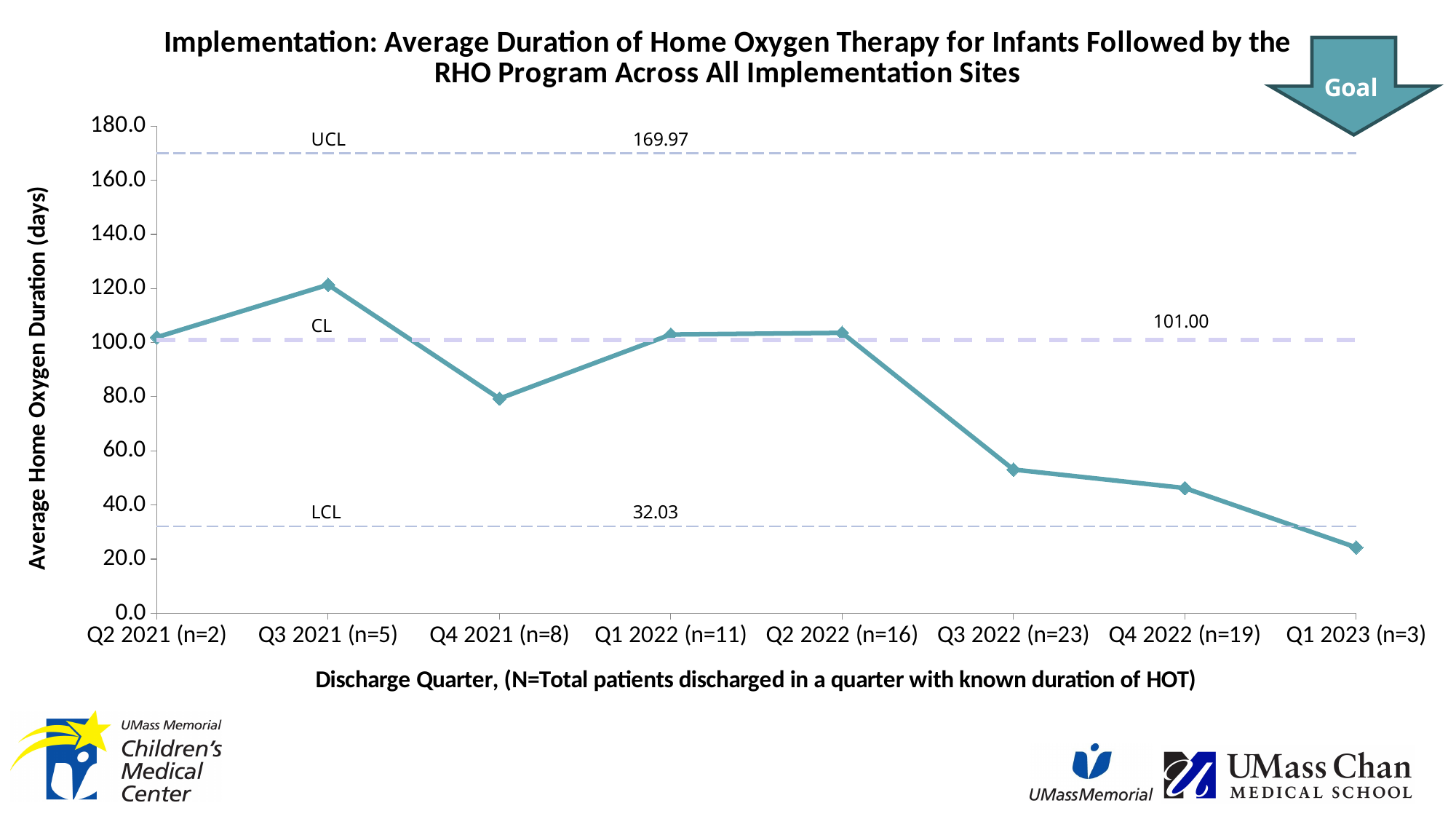
What is the value of the lower control limit (LCL) shown on the chart? 32.03 Is the average home oxygen duration for Q3 2021 (n=5) greater or less than 100.0 days? greater What kind of chart is shown on the slide? line chart What is the value of the center line (CL) shown on the chart? 101.00 Is the average home oxygen duration for Q1 2023 (n=3) greater or less than 40.0 days? less Which discharge quarter has the lowest average home oxygen duration? Q1 2023 (n=3) Which has the larger average home oxygen duration, Q3 2021 (n=5) or Q4 2021 (n=8)? Q3 2021 (n=5) Which discharge quarter has the highest average home oxygen duration? Q3 2021 (n=5) How many discharge quarters are plotted on the x axis? 8 Is the average home oxygen duration for Q3 2022 (n=23) greater or less than 60.0 days? less Do the average home oxygen duration values rise or fall from Q2 2022 (n=16) to Q1 2023 (n=3)? fall What is the value of the upper control limit (UCL) shown on the chart? 169.97